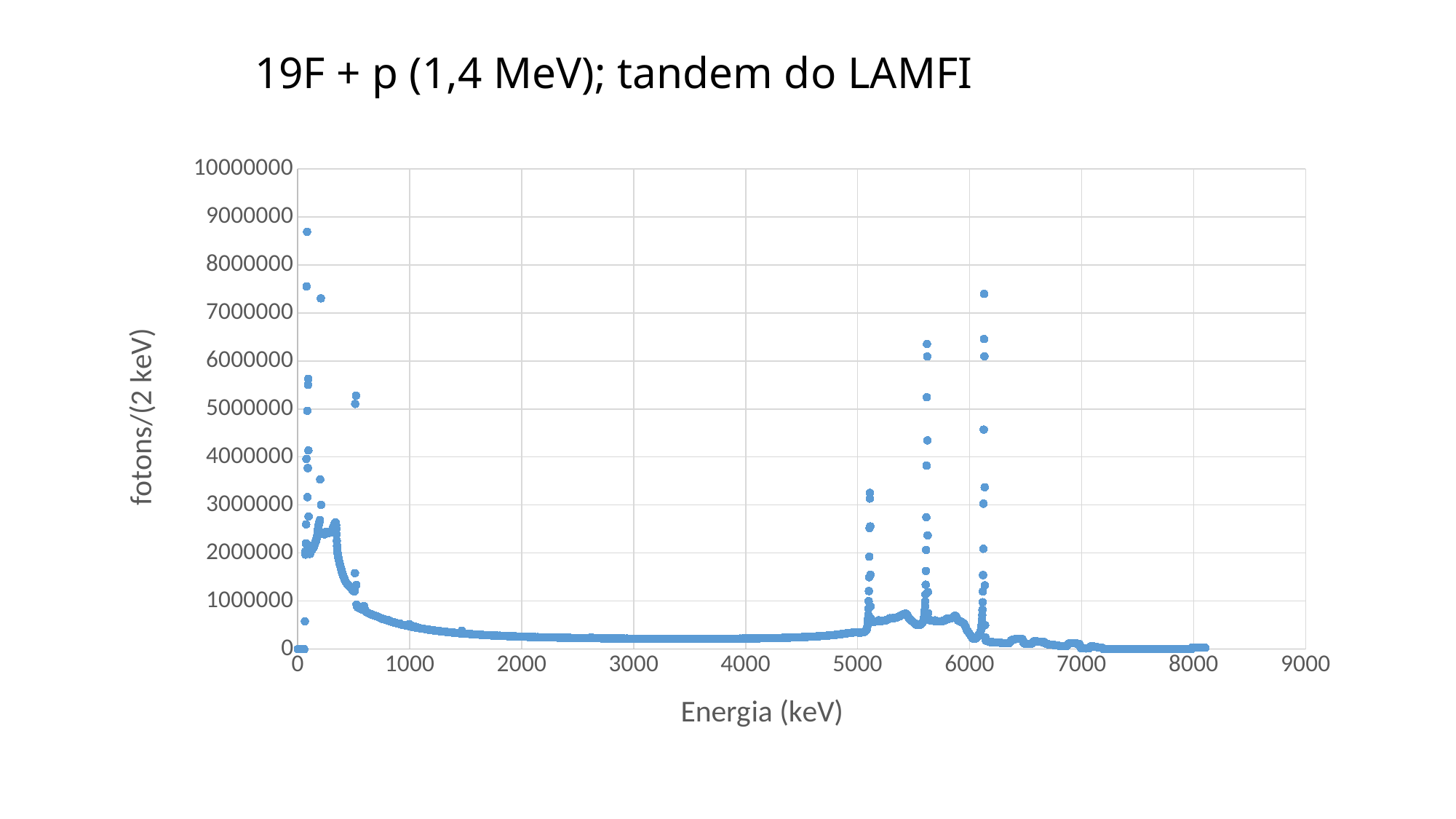
Which peak reaches a higher value: the one near 5100 keV or the one near 5600 keV? the one near 5600 keV Do the values rise or fall as energy increases from 1000 keV to 3000 keV? fall Is the tallest point of the peak near 5600 keV greater or less than 7000000? less Is the tallest point of the peak near 6100 keV greater or less than 7000000? greater Are the values between 2000 keV and 5000 keV greater or less than 1000000? less What is the highest value shown on the y axis? 10000000 Which peak reaches a higher value: the one near 5600 keV or the one near 6100 keV? the one near 6100 keV What is the title of the chart? 19F + p (1,4 MeV); tandem do LAMFI What is the label of the x axis? Energia (keV) What kind of chart is shown on the slide? scatter chart